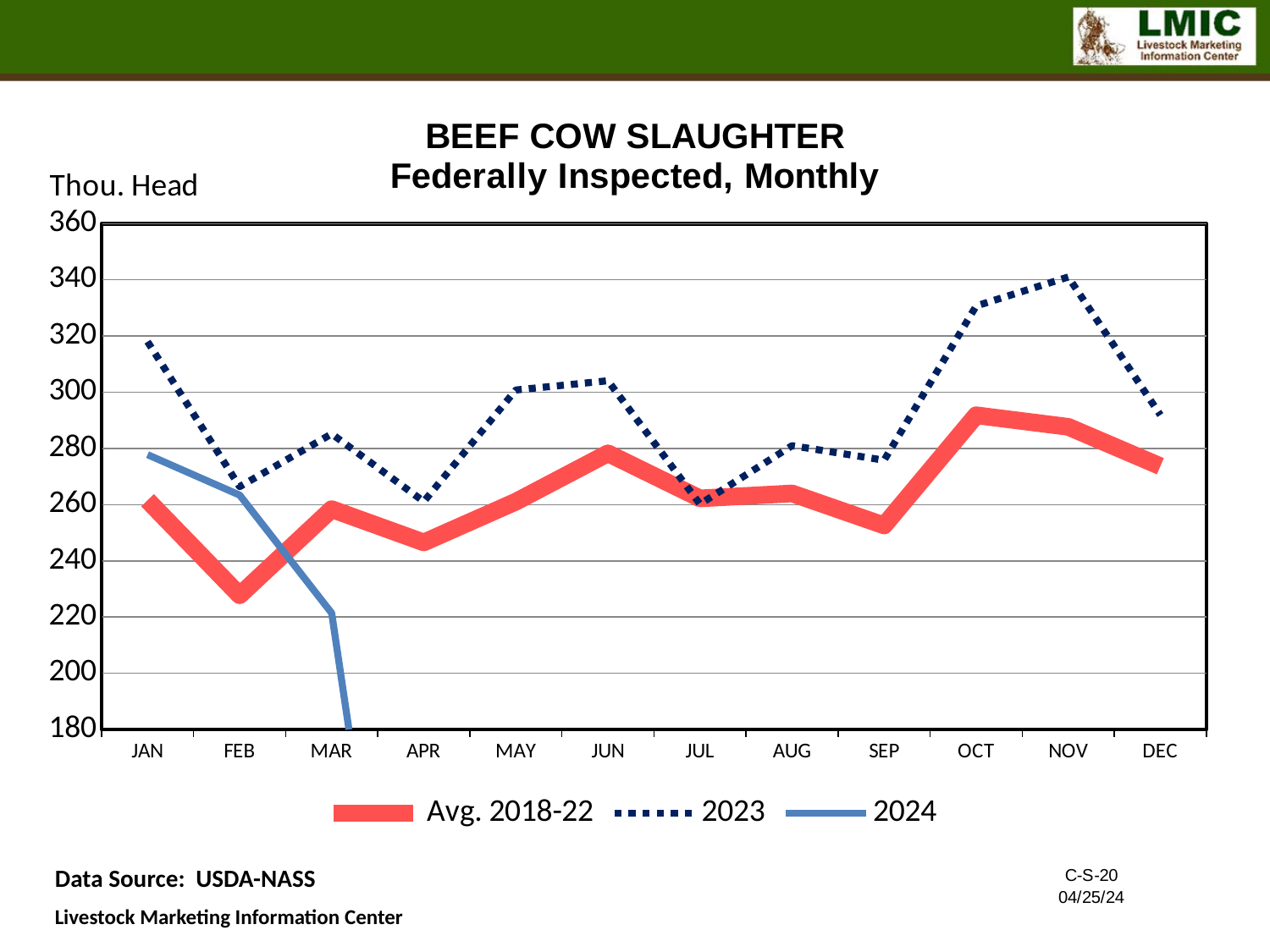
How many months are shown along the x axis? 12 Which is larger in MAR, the 2024 value or the Avg. 2018-22 value? Avg. 2018-22 Is the 2023 value for JAN greater or less than 300? greater What kind of chart is shown on the slide? line chart How many series does the legend list? 3 In which month does the 2023 series reach its highest value? NOV Does the 2024 series rise or fall from JAN to MAR? fall Which is larger in JAN, the 2023 value or the Avg. 2018-22 value? 2023 Is the 2024 value for MAR greater or less than 240? less In which month is the Avg. 2018-22 series at its lowest? FEB What unit label is shown on the y axis of the chart? Thou. Head Is the 2023 value for NOV greater or less than 320? greater